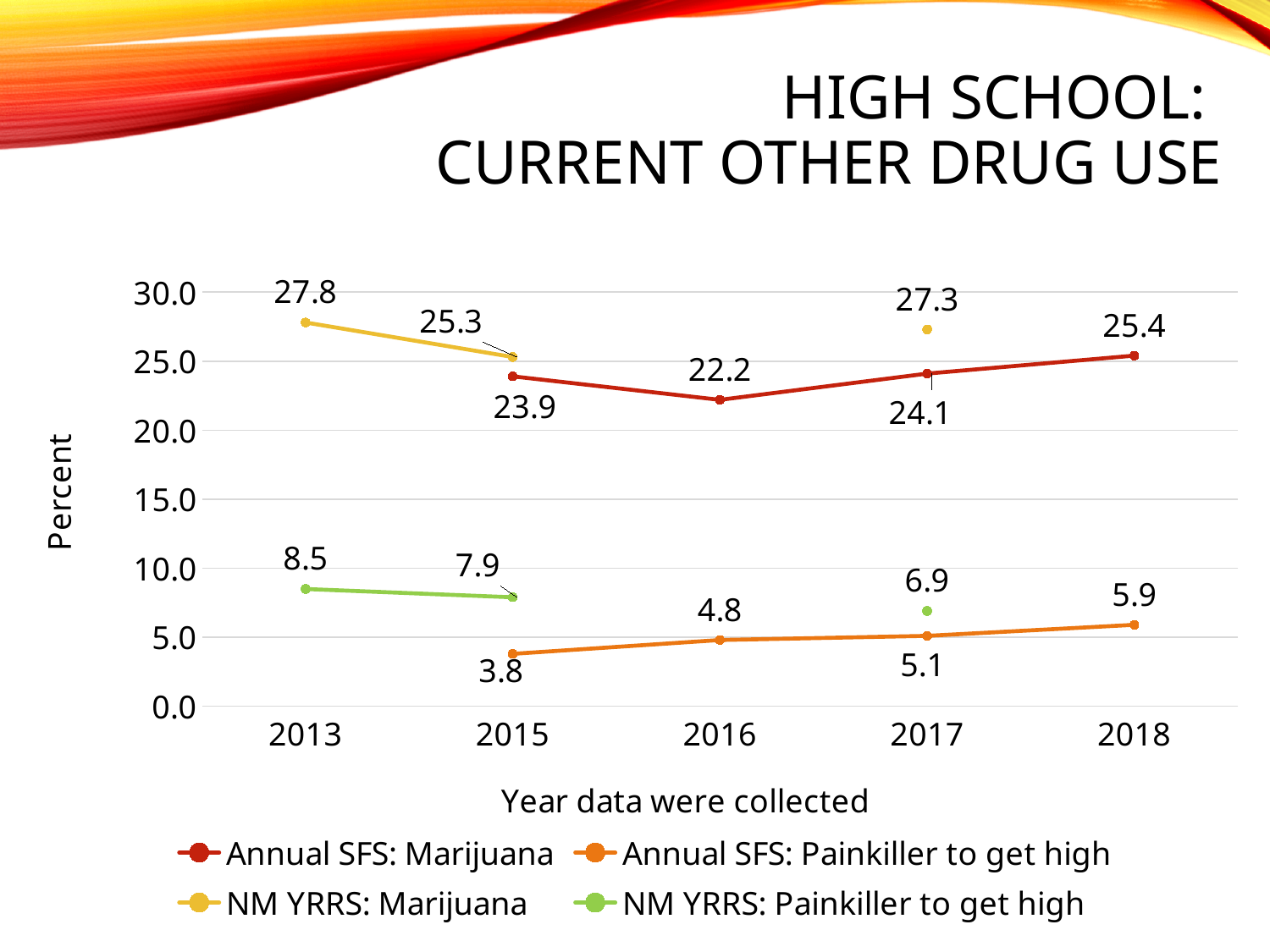
What is the value for Annual SFS: Marijuana in 2018? 25.4 Do the Annual SFS: Painkiller to get high values rise or fall from 2015 to 2018? Rise What is the value for Annual SFS: Painkiller to get high in 2015? 3.8 What is the value for NM YRRS: Painkiller to get high in 2017? 6.9 What kind of chart is shown on the slide? Line chart In 2017, which is larger: NM YRRS: Marijuana or Annual SFS: Marijuana? NM YRRS: Marijuana What is the difference between the NM YRRS: Marijuana values in 2013 and 2015? 2.5 What is the value for NM YRRS: Marijuana in 2013? 27.8 In which year is the Annual SFS: Marijuana value lowest? 2016 How many years are shown on the x axis? 5 In which year is the Annual SFS: Marijuana value highest? 2018 How many series does the legend list? 4